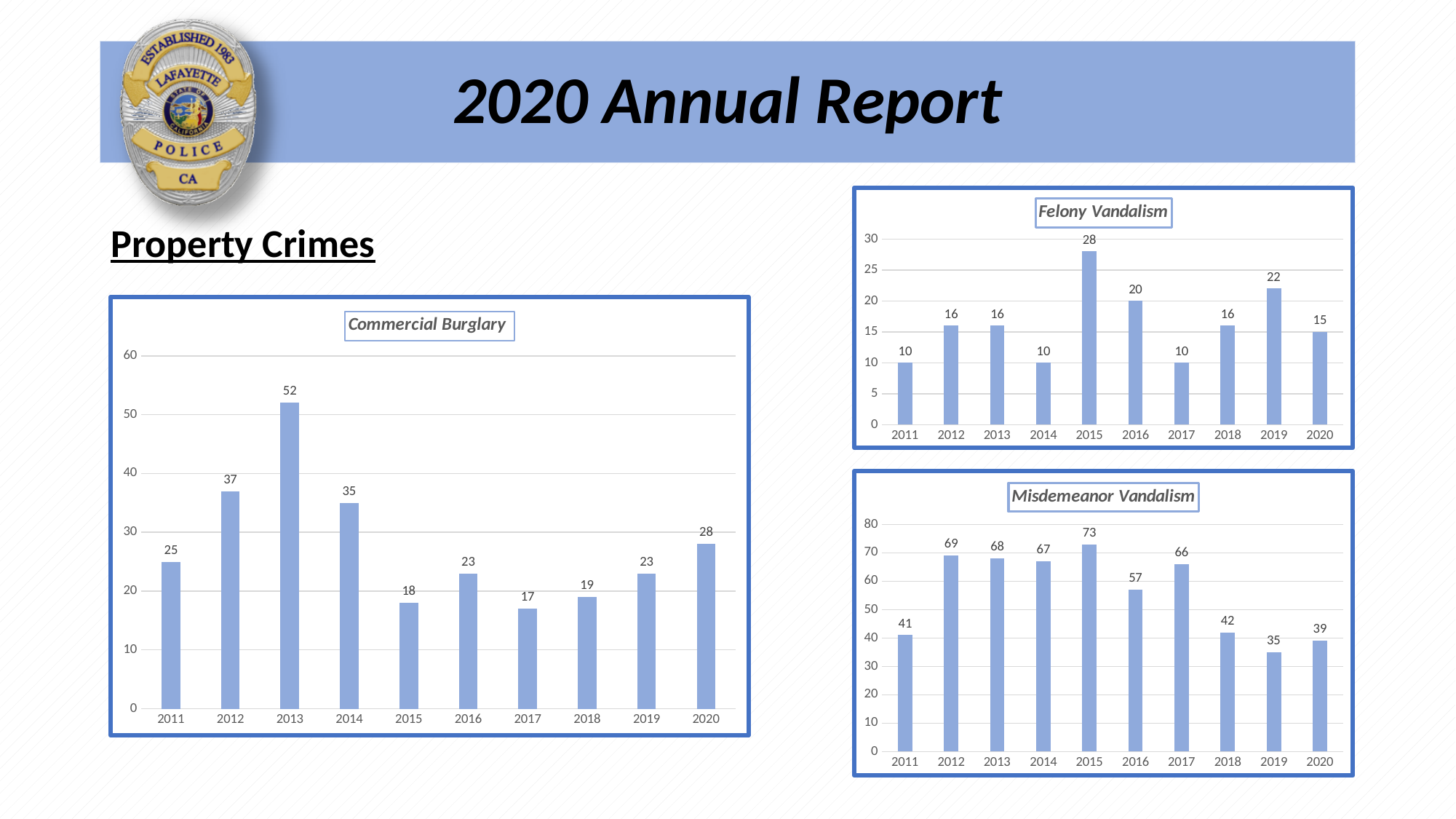
In the Misdemeanor Vandalism chart, which year has the lowest value? 2019 In the Felony Vandalism chart, which is larger, the value for 2016 or the value for 2020? 2016 In the Commercial Burglary chart, which year has the lowest value? 2017 How many years are shown on the x axis of the Misdemeanor Vandalism chart? 10 In the Commercial Burglary chart, what is the value for 2013? 52 In the Felony Vandalism chart, which year has the highest value? 2015 In the Commercial Burglary chart, what is the difference between the values for 2020 and 2019? 5 In the Misdemeanor Vandalism chart, what is the value for 2018? 42 In the Misdemeanor Vandalism chart, what is the difference between the values for 2015 and 2016? 16 In the Felony Vandalism chart, what is the value for 2019? 22 In the Misdemeanor Vandalism chart, do the values rise or fall from 2017 to 2019? Fall What kind of chart is the Commercial Burglary chart? Bar chart